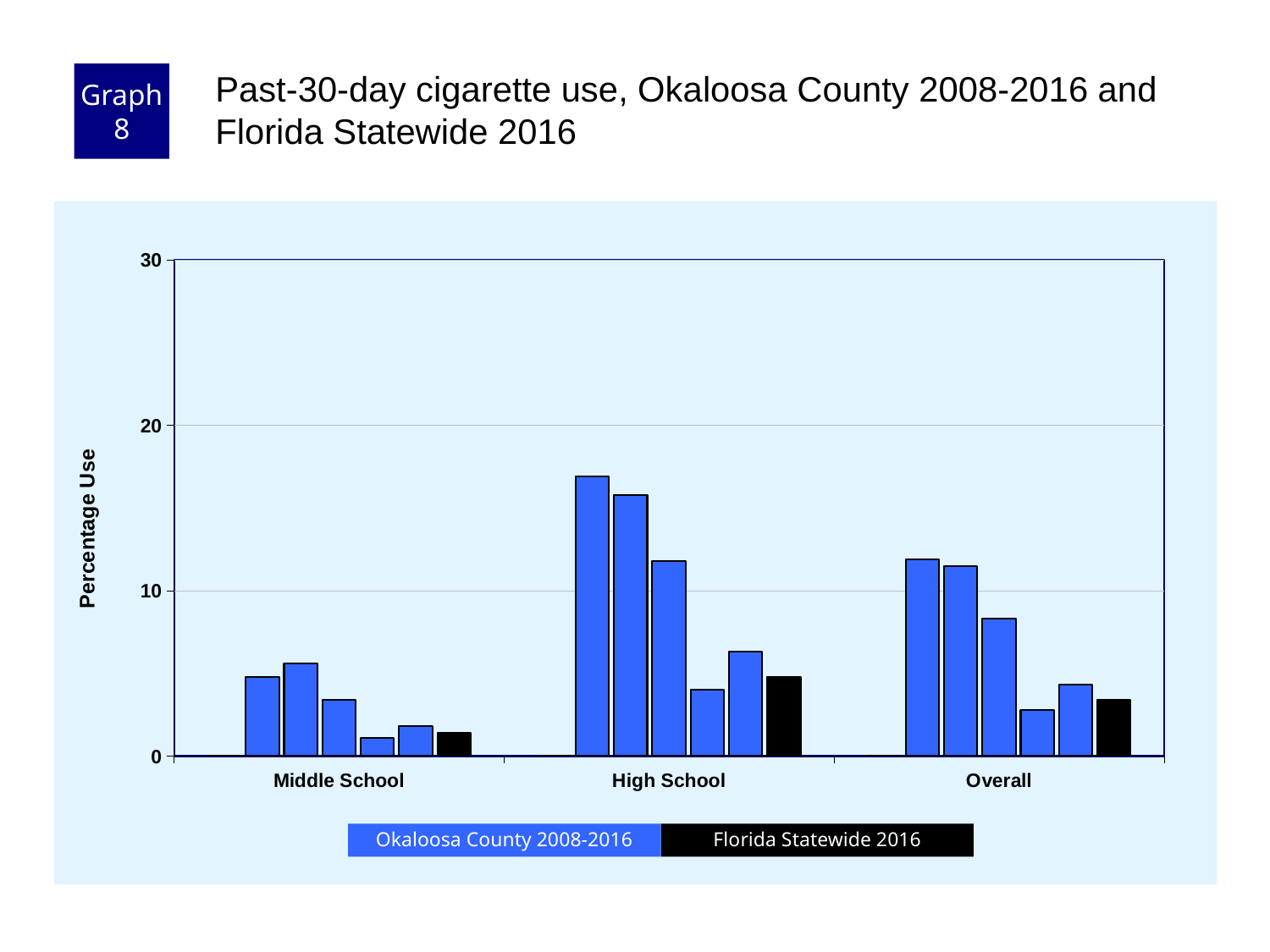
How many series does the legend list? 2 Is the tallest Okaloosa County bar for High School greater or less than 10? greater Is the tallest Okaloosa County bar for Middle School greater or less than 10? less Which category has the highest Florida Statewide 2016 value? High School How many categories are shown on the x axis? 3 Is the Florida Statewide 2016 value larger for High School or for Middle School? High School What kind of chart is shown on the slide? bar chart Which category has the lowest Florida Statewide 2016 value? Middle School Is the Florida Statewide 2016 value for High School greater or less than 10? less What is the label of the y axis? Percentage Use Which colour represents Florida Statewide 2016 in the legend? black